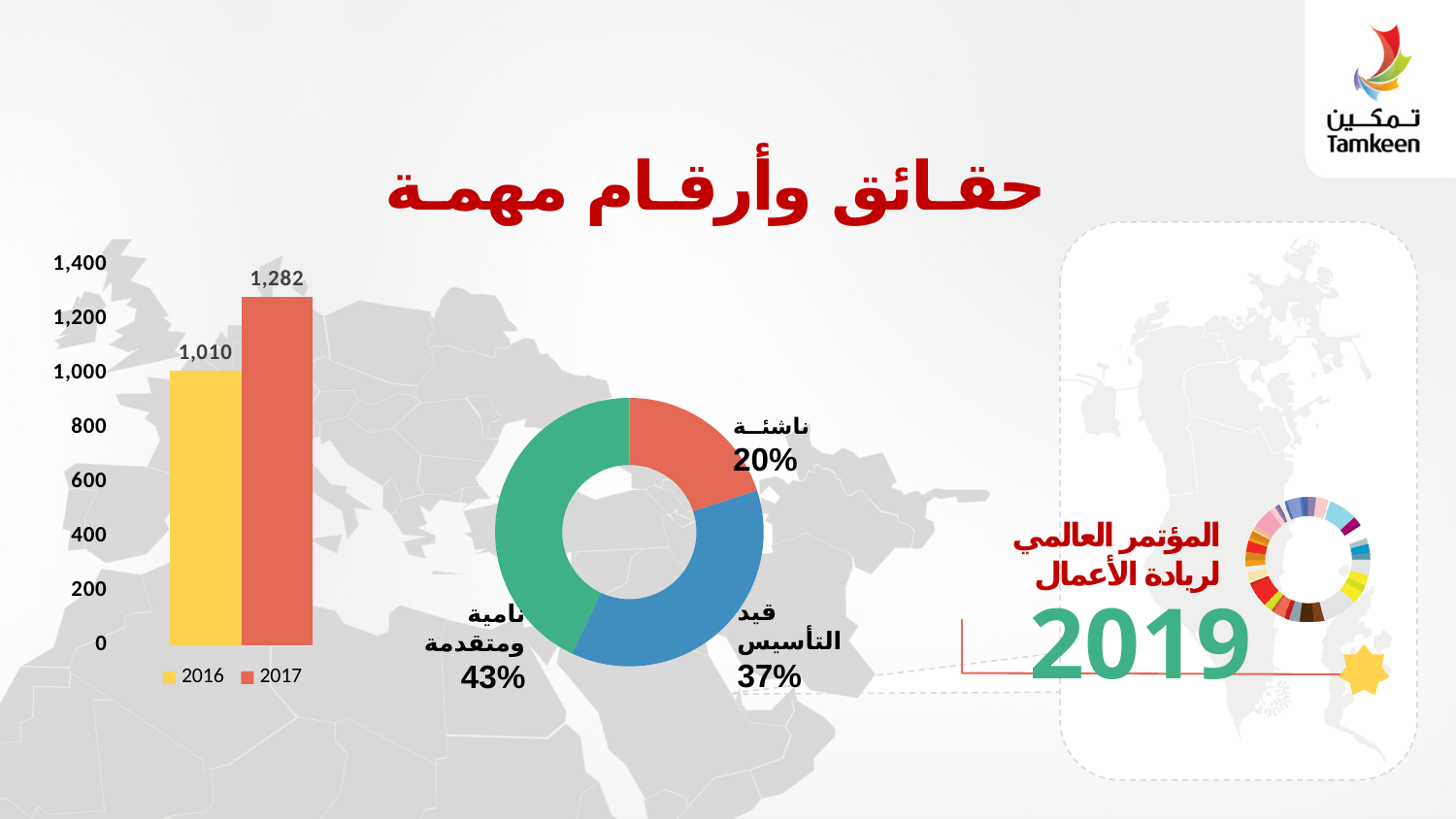
In the donut chart in the middle, what share is labelled قيد التأسيس? 37% In the bar chart on the left, what is the value for 2016? 1,010 In the bar chart on the left, how many series does the legend list? 2 In the bar chart on the left, what is the value for 2017? 1,282 In the bar chart on the left, which year has the higher value? 2017 What kind of chart is shown on the left of the slide? bar chart In the donut chart in the middle, which category has the smallest share? ناشئة In the bar chart on the left, is the value for 2017 greater or less than 1,200? greater In the donut chart in the middle, what share is labelled ناشئة? 20% In the donut chart in the middle, which category has the largest share? نامية ومتقدمة In the bar chart on the left, what is the difference between the 2017 and 2016 values? 272 In the donut chart in the middle, how many categories are shown? 3